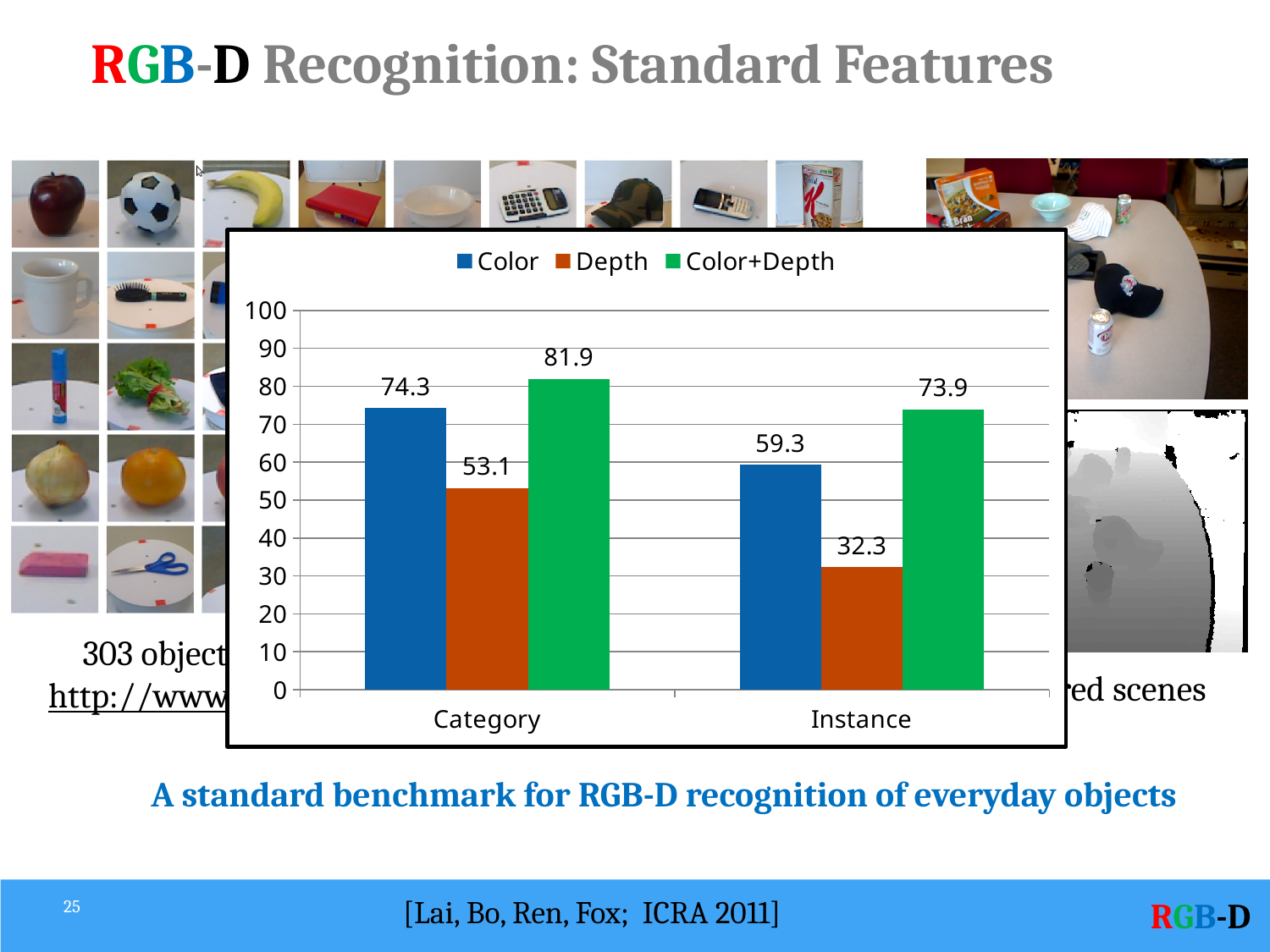
What is the difference between the Depth values for Category and Instance? 20.8 How many series does the legend list? 3 What is the Color+Depth value for Category? 81.9 How many categories are shown on the x axis? 2 What is the Color value for Category? 74.3 Which series has the lowest value for Category? Depth What kind of chart is shown on the slide? Bar chart What is the difference between the Color+Depth and Color values for Category? 7.6 Which series has the highest value for Instance? Color+Depth Which is larger, the Depth value for Category or the Color value for Instance? Color value for Instance What is the Color value for Instance? 59.3 What is the Depth value for Instance? 32.3